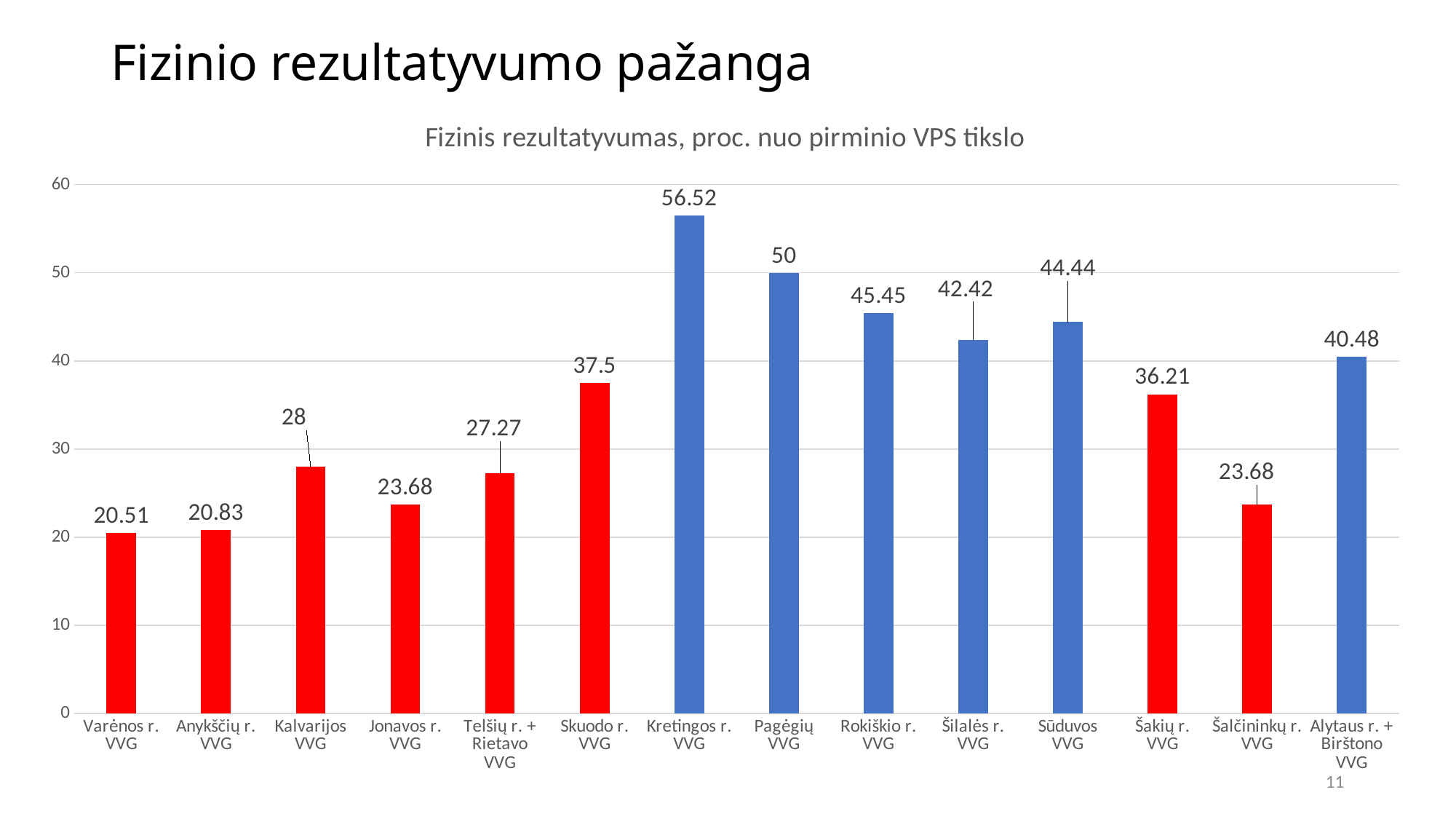
What is the value for Šakių r. VVG? 36.21 Which is larger, the value for Rokiškio r. VVG or the value for Sūduvos VVG? Rokiškio r. VVG What is the value for Telšių r. + Rietavo VVG? 27.27 What is the title of the chart? Fizinis rezultatyvumas, proc. nuo pirminio VPS tikslo What kind of chart is shown on the slide? bar chart What is the difference between the values for Pagėgių VVG and Skuodo r. VVG? 12.5 Is the value for Alytaus r. + Birštono VVG greater or less than 40? greater Which category has the highest value? Kretingos r. VVG How many categories are shown on the x axis? 14 What is the value for Kretingos r. VVG? 56.52 Which category has the lowest value? Varėnos r. VVG What colour is the bar for Kalvarijos VVG? red